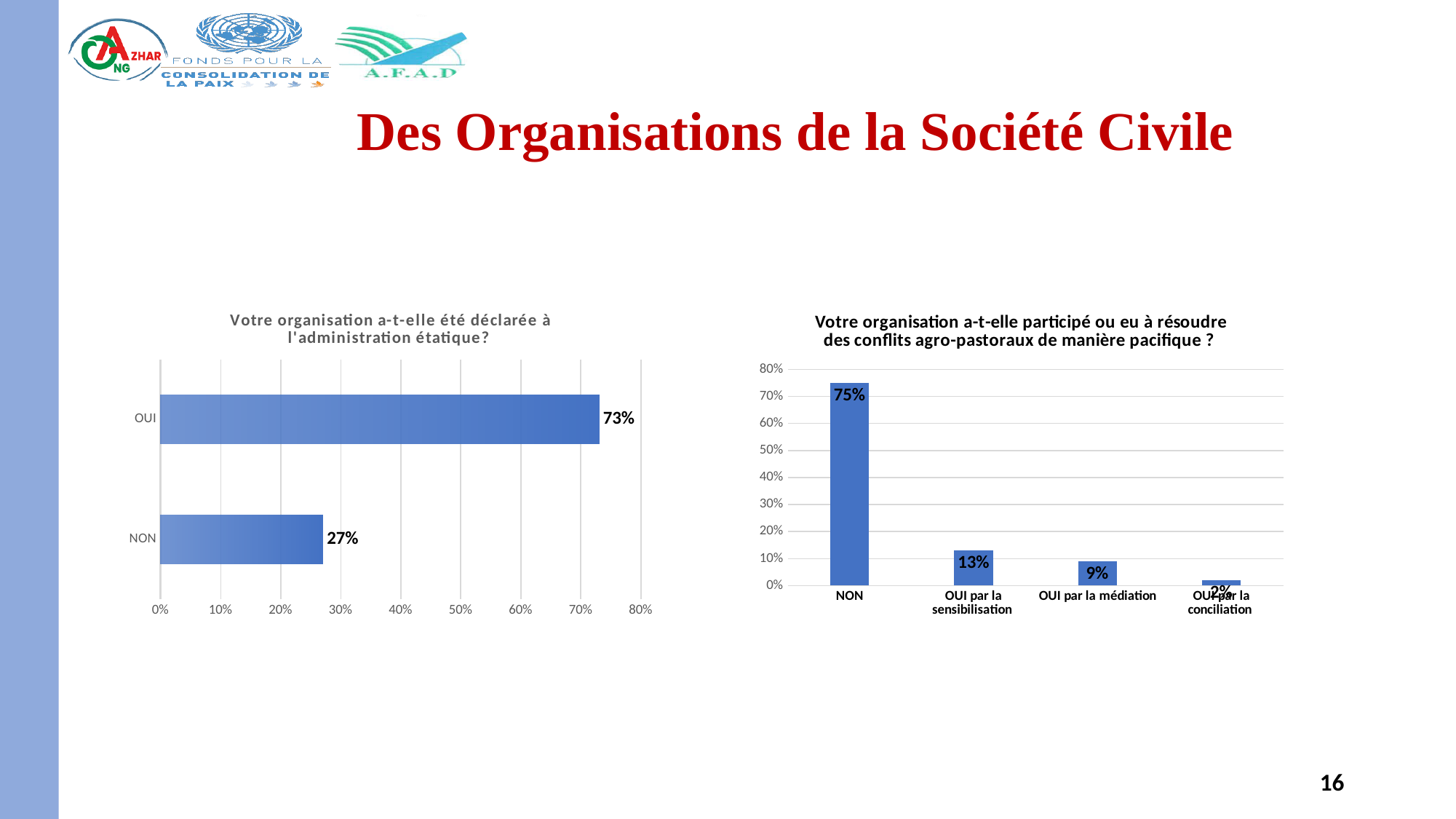
In the right chart ("Votre organisation a-t-elle participé ou eu à résoudre des conflits agro-pastoraux de manière pacifique ?"), what is the value for OUI par la médiation? 9% In the right chart ("Votre organisation a-t-elle participé ou eu à résoudre des conflits agro-pastoraux de manière pacifique ?"), which category has the lowest value? OUI par la conciliation In the right chart ("Votre organisation a-t-elle participé ou eu à résoudre des conflits agro-pastoraux de manière pacifique ?"), what is the value for OUI par la sensibilisation? 13% In the right chart ("Votre organisation a-t-elle participé ou eu à résoudre des conflits agro-pastoraux de manière pacifique ?"), what is the value for NON? 75% In the right chart ("Votre organisation a-t-elle participé ou eu à résoudre des conflits agro-pastoraux de manière pacifique ?"), what is the difference between the values for OUI par la sensibilisation and OUI par la médiation? 4% In the left chart ("Votre organisation a-t-elle été déclarée à l'administration étatique?"), what is the value for NON? 27% In the left chart ("Votre organisation a-t-elle été déclarée à l'administration étatique?"), what is the difference between the OUI and NON values? 46% In the right chart ("Votre organisation a-t-elle participé ou eu à résoudre des conflits agro-pastoraux de manière pacifique ?"), how many categories are shown? 4 In the left chart ("Votre organisation a-t-elle été déclarée à l'administration étatique?"), what is the value for OUI? 73% In the left chart ("Votre organisation a-t-elle été déclarée à l'administration étatique?"), what kind of chart is shown? Bar chart In the right chart ("Votre organisation a-t-elle participé ou eu à résoudre des conflits agro-pastoraux de manière pacifique ?"), which category has the highest value? NON In the left chart ("Votre organisation a-t-elle été déclarée à l'administration étatique?"), how many categories are shown? 2